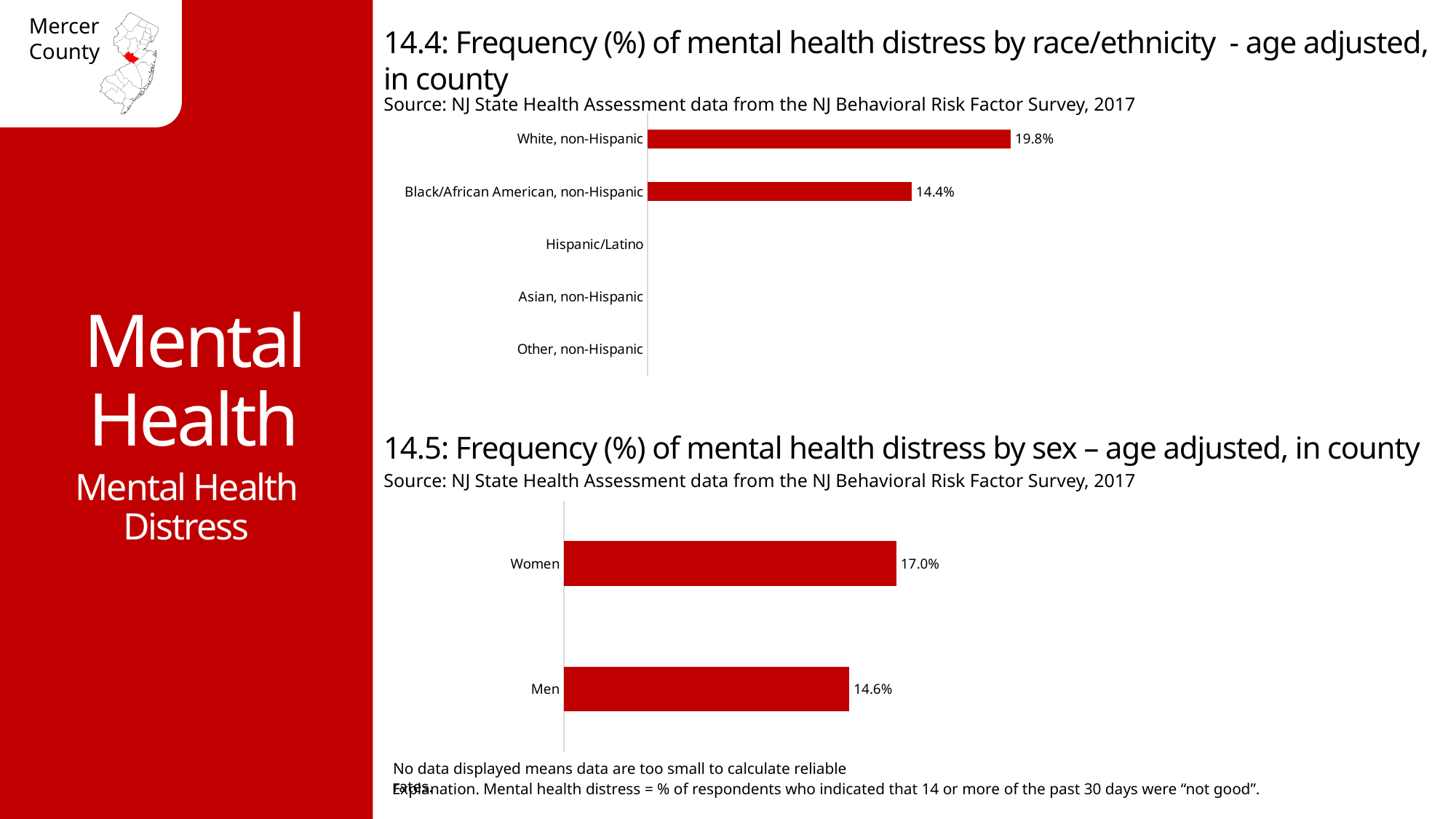
In chart 14.4 (mental health distress by race/ethnicity), how many race/ethnicity categories are listed on the axis? 5 In chart 14.5 (mental health distress by sex), what is the value for Men? 14.6% What is the source cited for chart 14.5 (mental health distress by sex)? NJ State Health Assessment data from the NJ Behavioral Risk Factor Survey, 2017 In chart 14.5 (mental health distress by sex), what is the value for Women? 17.0% In chart 14.4 (mental health distress by race/ethnicity), how many categories have a bar displayed? 2 In chart 14.4 (mental health distress by race/ethnicity), what is the difference between the White, non-Hispanic and Black/African American, non-Hispanic values? 5.4% In chart 14.5 (mental health distress by sex), which group has the higher value, Women or Men? Women In chart 14.4 (mental health distress by race/ethnicity), what is the value for Black/African American, non-Hispanic? 14.4% What kind of chart is chart 14.4 (mental health distress by race/ethnicity)? Bar chart In chart 14.5 (mental health distress by sex), what is the difference between the Women and Men values? 2.4% In chart 14.4 (mental health distress by race/ethnicity), which category has the highest value? White, non-Hispanic In chart 14.4 (mental health distress by race/ethnicity), what is the value for White, non-Hispanic? 19.8%